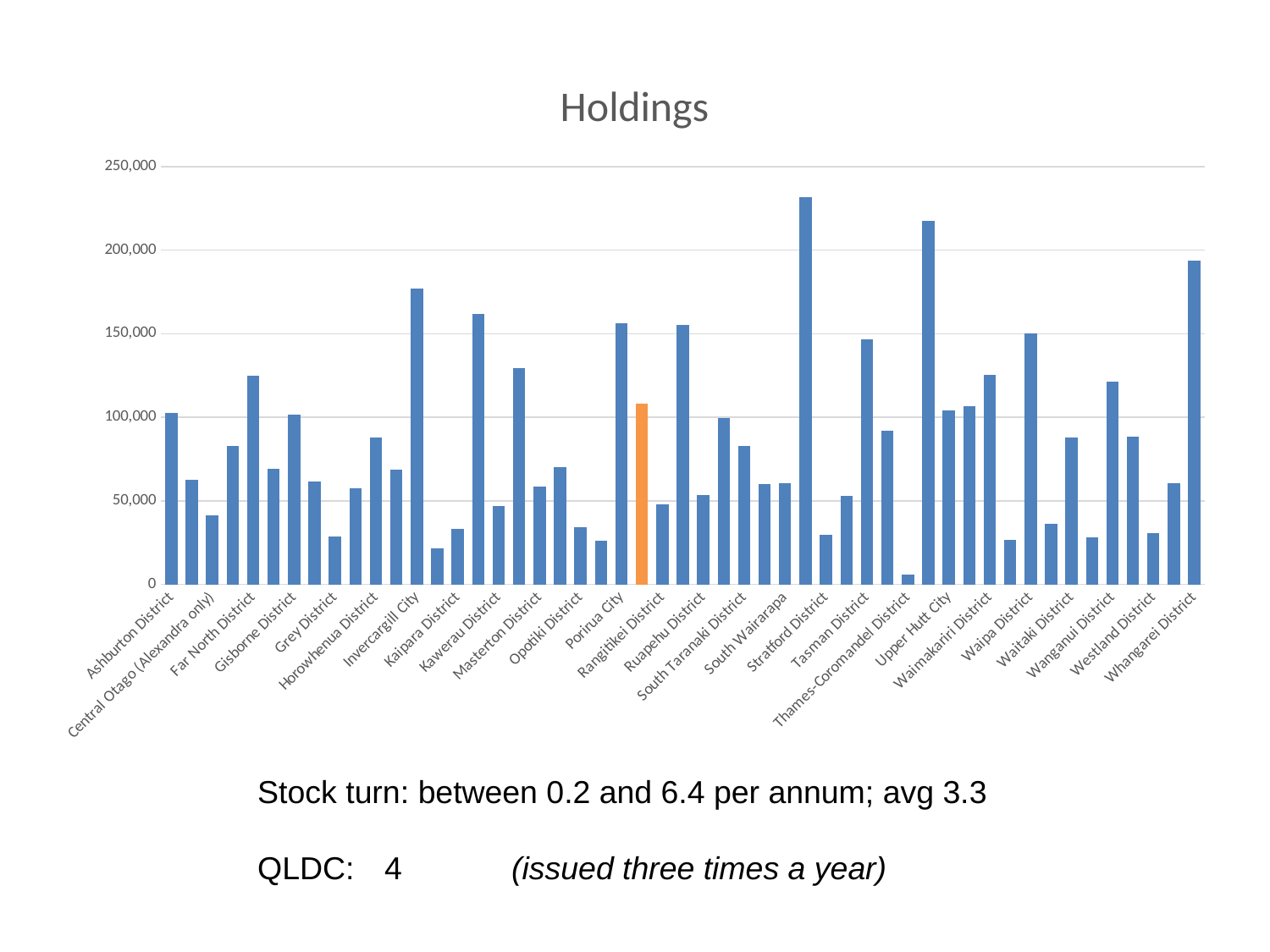
Is the value for Whangarei District greater or less than 150,000? greater Is the value for Thames-Coromandel District greater or less than 50,000? less Is the value for Grey District greater or less than 50,000? less Which labelled district has the lowest holdings value? Thames-Coromandel District Which has the larger value, Whangarei District or Westland District? Whangarei District What kind of chart is shown on the slide? bar chart Which has the larger value, Far North District or Central Otago (Alexandra only)? Far North District What is the title of the chart? Holdings Which has the larger value, Invercargill City or Kaipara District? Invercargill City